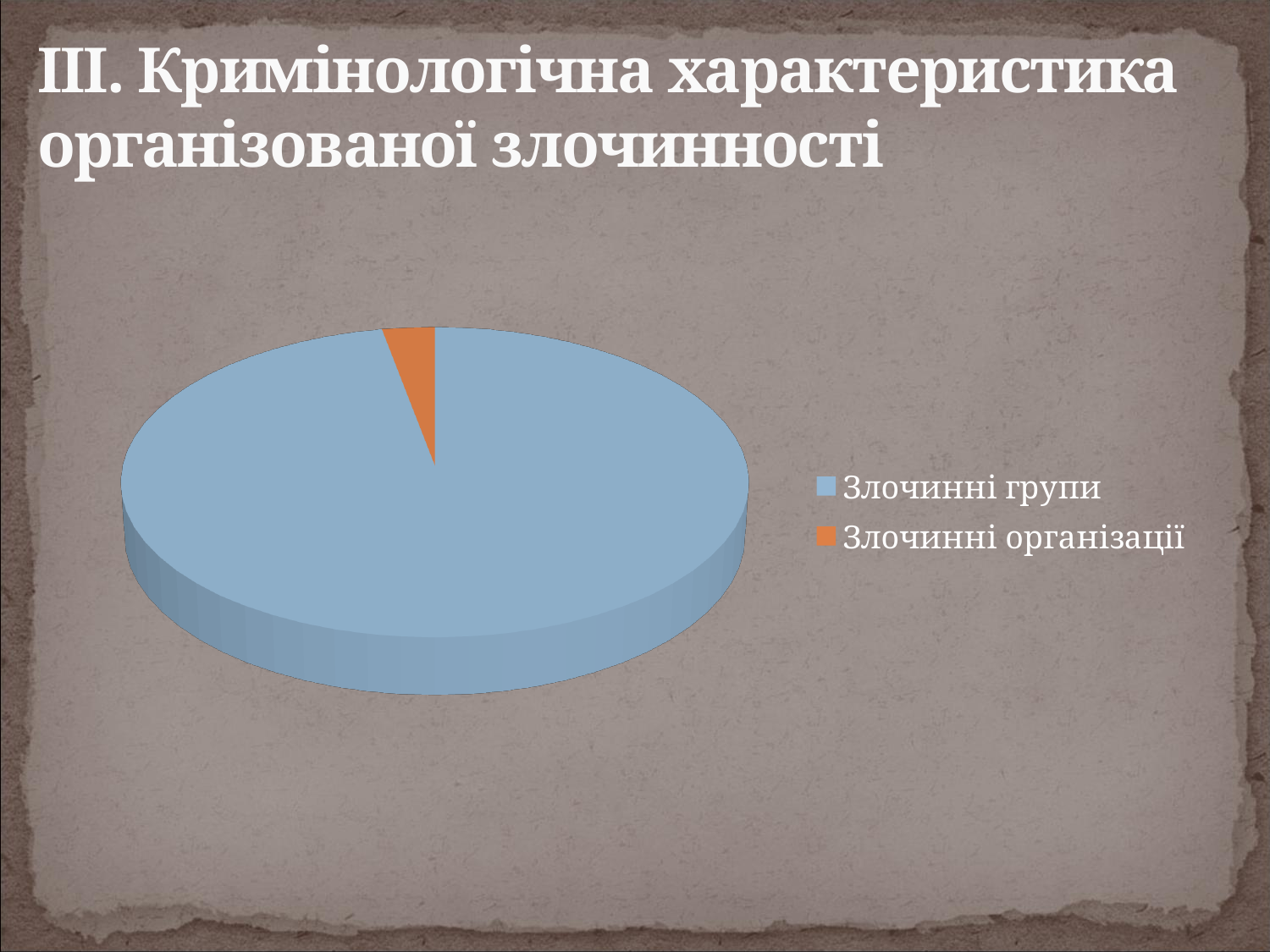
Which slice is larger, Злочинні групи or Злочинні організації? Злочинні групи What colour is the slice for Злочинні групи? blue How many entries does the legend of the pie chart list? 2 Which category has the largest slice in the pie chart? Злочинні групи What colour is the slice for Злочинні організації? orange What kind of chart is shown on the slide? pie chart How many slices does the pie chart have? 2 Which category has the smallest slice in the pie chart? Злочинні організації